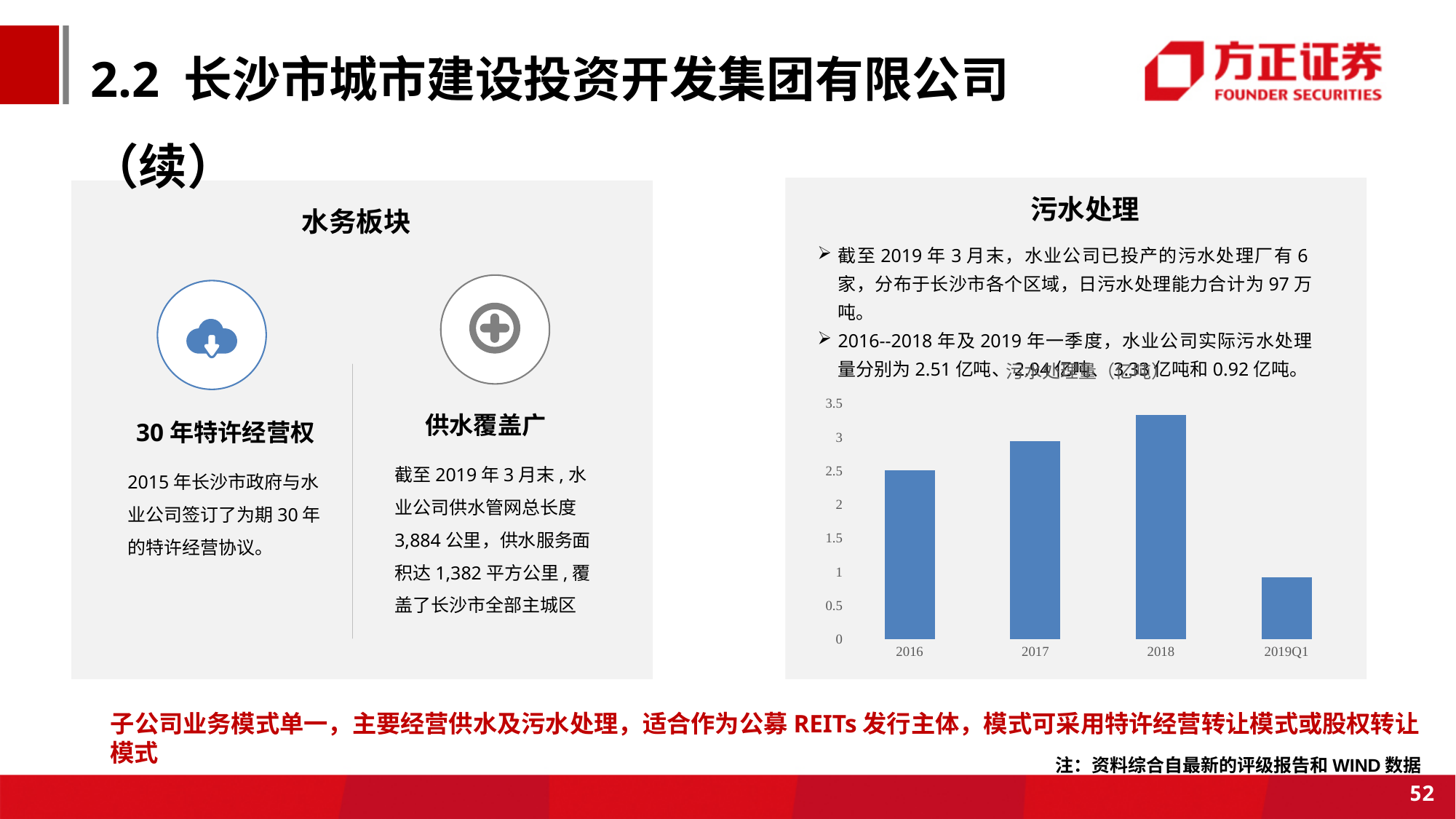
What is the label of the first category on the x axis of the 污水处理量 chart? 2016 Which category has the lowest bar in the 污水处理量 chart? 2019Q1 What is the title of the bar chart on the slide? 污水处理量（亿吨） In the 污水处理量 chart, is the value for 2019Q1 greater or less than 1? less How many categories are shown on the x axis of the 污水处理量 chart? 4 Which category has the highest bar in the 污水处理量 chart? 2018 What kind of chart is shown under the 污水处理 section? bar chart In the 污水处理量 chart, do the values rise or fall from 2016 to 2018? rise In the 污水处理量 chart, is the value for 2016 greater or less than 2? greater In the 污水处理量 chart, which is larger, the value for 2017 or the value for 2018? 2018 In the 污水处理量 chart, is the value for 2018 greater or less than 3? greater In the 污水处理量 chart, which is larger, the value for 2016 or the value for 2017? 2017